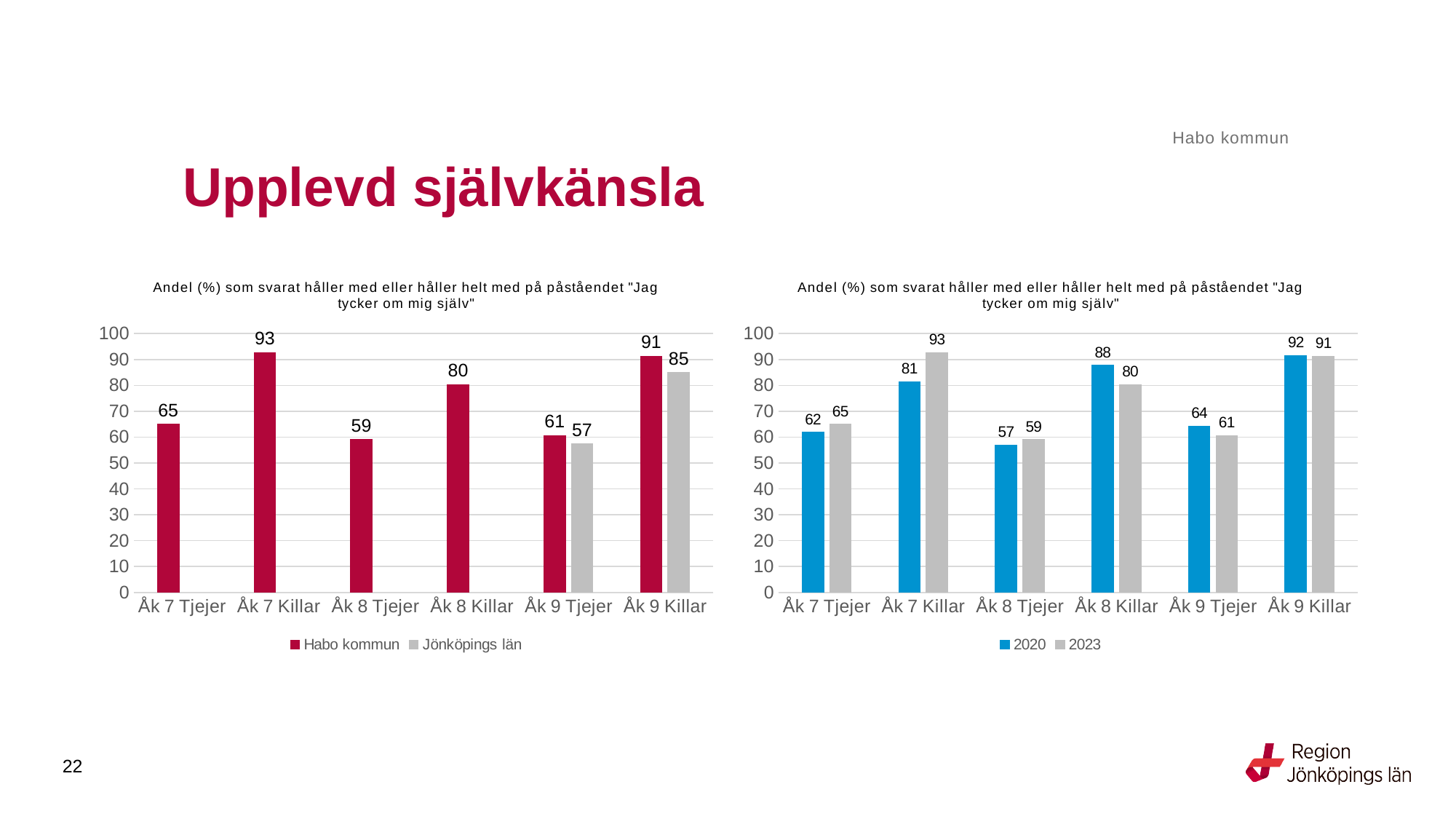
In the right chart, what is the value for 2023 for Åk 7 Tjejer? 65 In the right chart, which category has the highest value for 2023? Åk 7 Killar In the left chart, which category has the lowest value for Habo kommun? Åk 8 Tjejer In the left chart, what is the value for Jönköpings län for Åk 9 Tjejer? 57 In the right chart, what is the value for 2020 for Åk 8 Killar? 88 In the left chart, how many series does the legend list? 2 In the left chart, what is the difference between Habo kommun and Jönköpings län for Åk 9 Killar? 6 In the right chart, what is the difference between 2020 and 2023 for Åk 8 Killar? 8 In the right chart, how many categories are shown on the x axis? 6 What kind of chart is the right chart? Bar chart In the right chart, which is larger for Åk 7 Killar, 2020 or 2023? 2023 In the left chart, what is the value for Habo kommun for Åk 7 Killar? 93